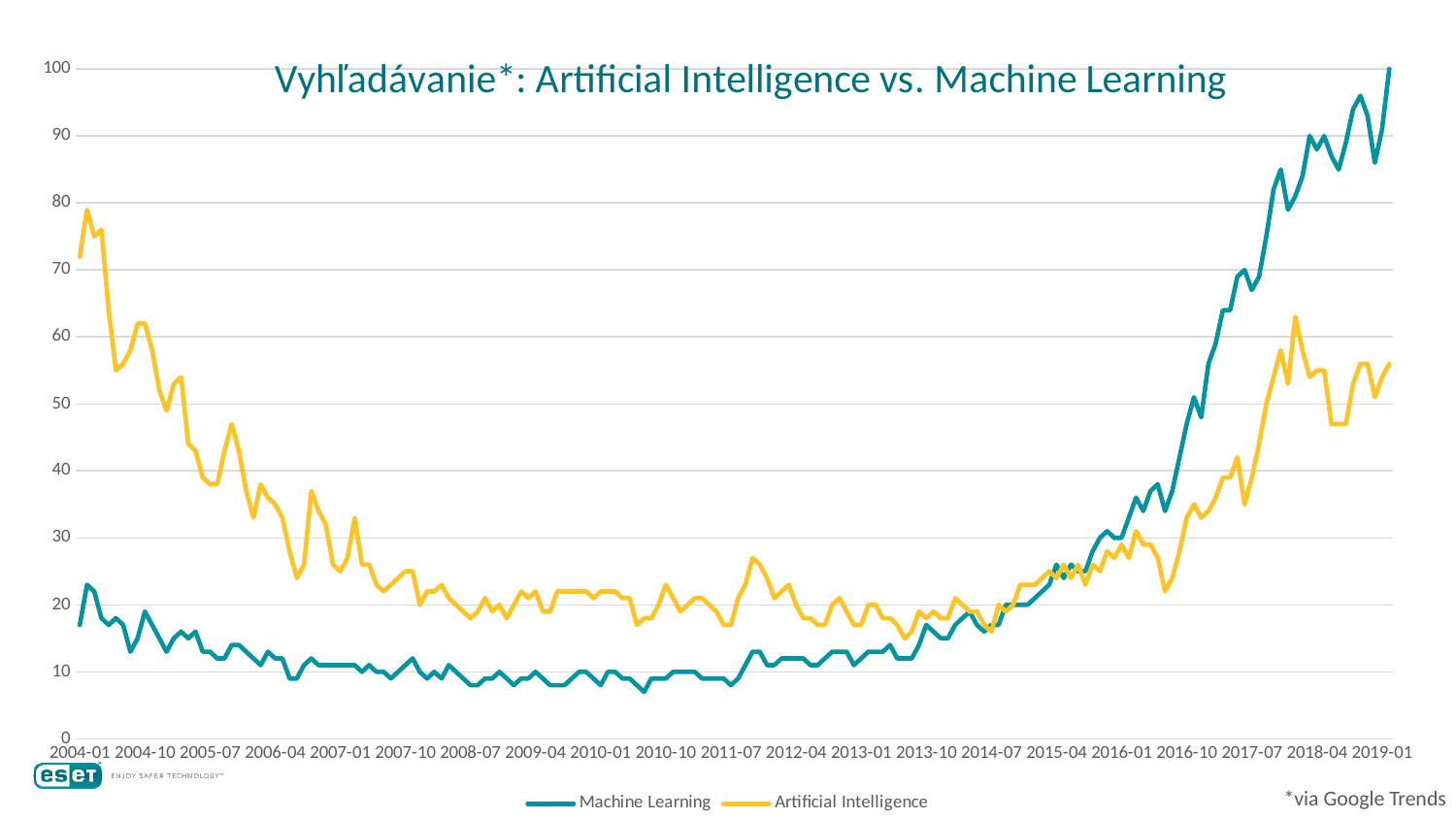
At 2004-01, which series has the higher value, Machine Learning or Artificial Intelligence? Artificial Intelligence What is the title of the chart? Vyhľadávanie*: Artificial Intelligence vs. Machine Learning Which colour is used for the Artificial Intelligence line? Yellow What kind of chart is shown on the slide? Line chart At 2019-01, which series has the higher value, Machine Learning or Artificial Intelligence? Machine Learning Does the Artificial Intelligence line rise or fall between 2004-01 and 2008-07? Fall Does the Machine Learning line rise or fall between 2015-04 and 2019-01? Rise Is the value for Machine Learning at 2010-01 greater or less than 20? less How many series does the legend list? 2 Is the value for Machine Learning at 2004-01 greater or less than 30? less Is the final value for Machine Learning at the right end of the chart greater or less than 90? greater